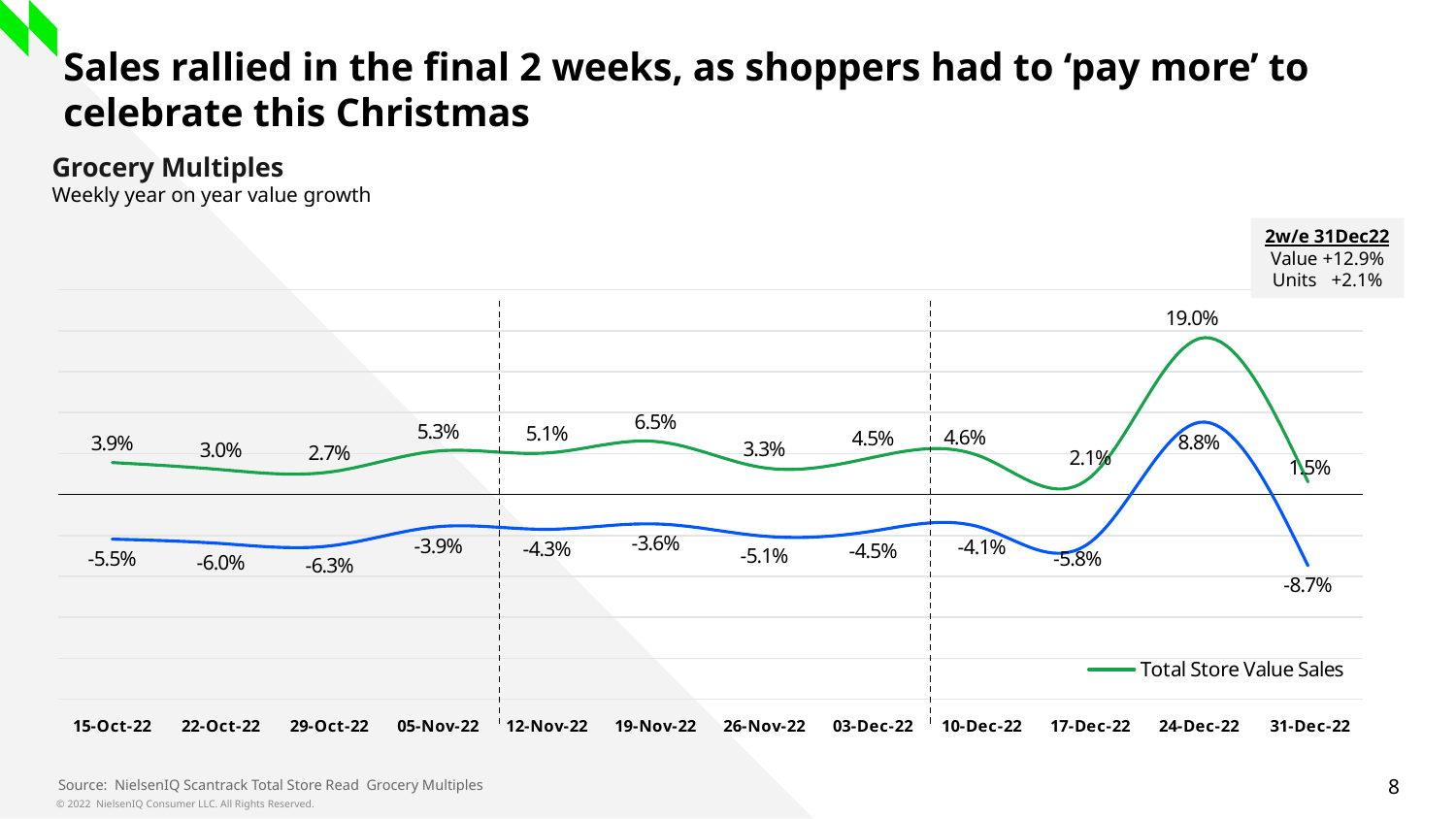
What is the value shown on the blue line for the week of 31-Dec-22? -8.7% What is the Total Store Value Sales growth for the week of 24-Dec-22? 19.0% How many weeks are shown on the x axis? 12 What kind of chart is shown on the slide? Line chart Which week has the lowest Total Store Value Sales growth? 31-Dec-22 What is the difference between the Total Store Value Sales growth for 24-Dec-22 and 17-Dec-22? 16.9 percentage points How many series does the legend list? 1 What is the Total Store Value Sales growth for the week of 19-Nov-22? 6.5% Which week has the highest Total Store Value Sales growth? 24-Dec-22 Which week has the higher Total Store Value Sales growth, 05-Nov-22 or 26-Nov-22? 05-Nov-22 Which week has the lowest value on the blue line? 31-Dec-22 What is the Total Store Value Sales growth for the week of 15-Oct-22? 3.9%